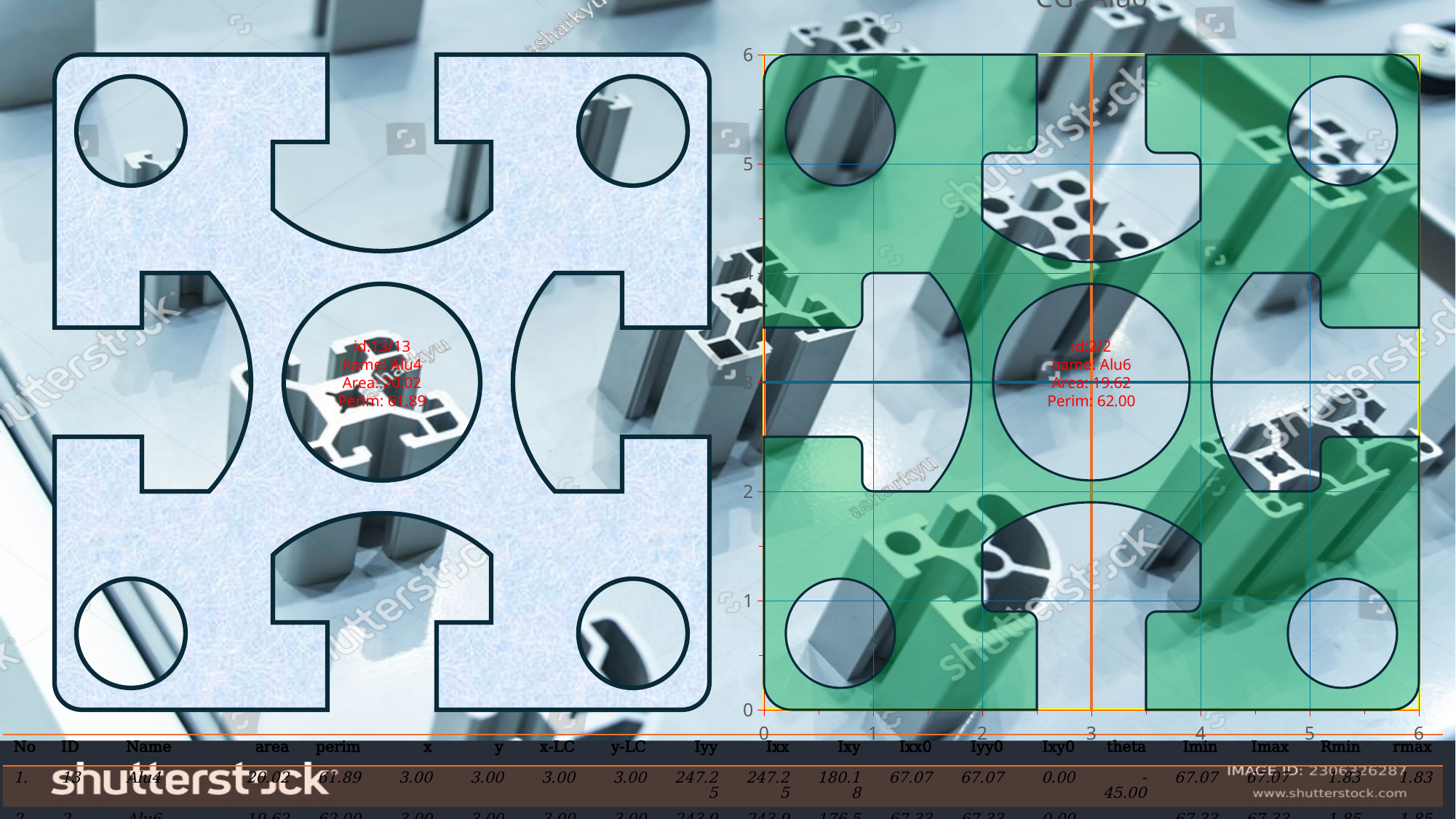
What is the Perim value printed on the right shape (name: Alu6)? 62.00 On the right plot, what is the highest value labelled on the x axis? 6 What is the difference between the printed Area of Alu4 and the printed Area of Alu6? 0.40 Which shape has the larger printed Area, Alu4 or Alu6? Alu4 On the right plot, what is the highest value labelled on the y axis? 6 What is the id printed on the right shape (Alu6)? 2/2 Which shape has the larger printed Perim, Alu4 or Alu6? Alu6 What is the difference between the printed Perim of Alu6 and the printed Perim of Alu4? 0.11 What is the Area value printed on the right shape (name: Alu6)? 19.62 What is the id printed on the left shape (Alu4)? 13/13 What is the Area value printed on the left shape (name: Alu4)? 20.02 What is the Perim value printed on the left shape (name: Alu4)? 61.89